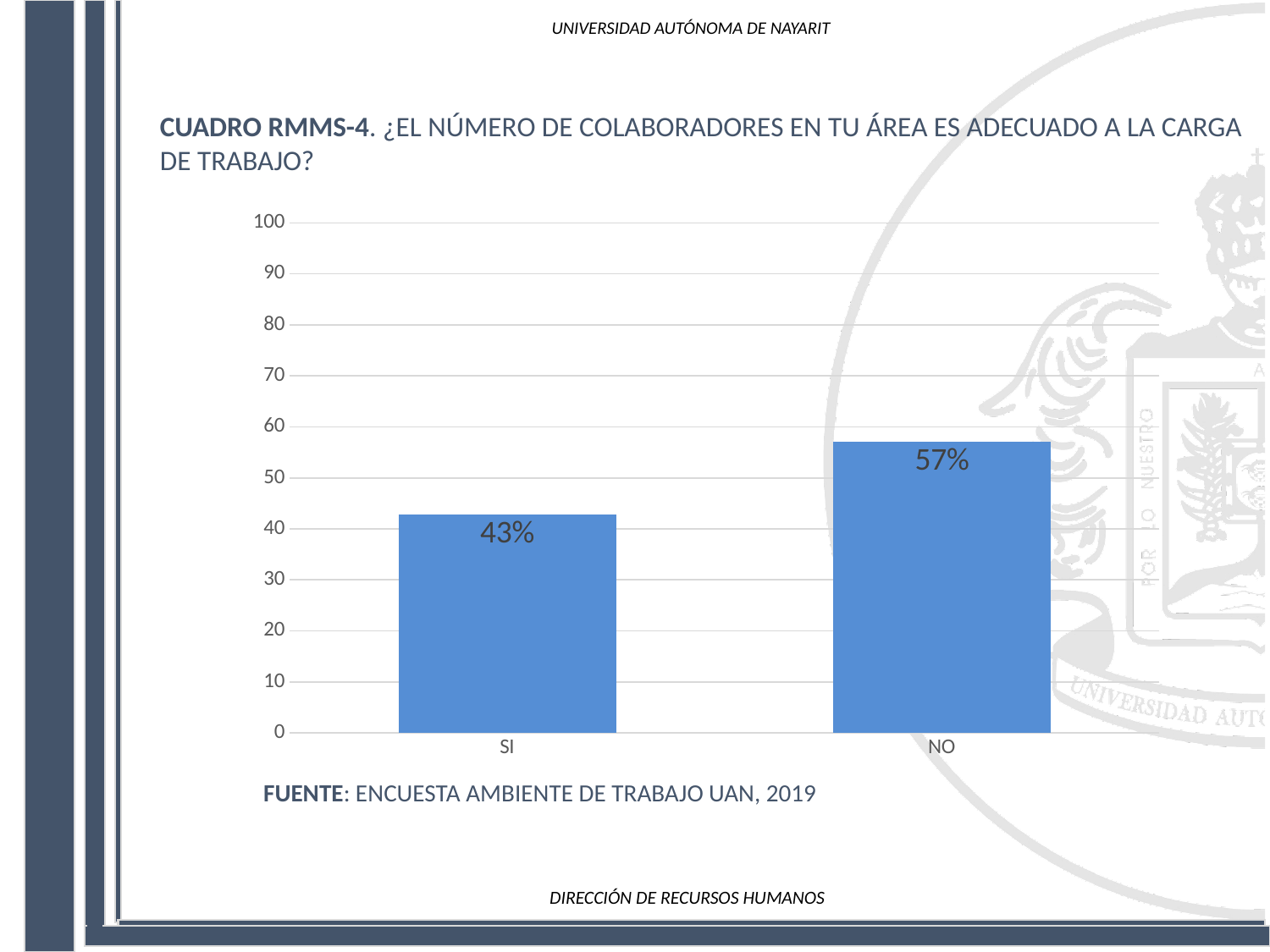
What source is cited below the chart? ENCUESTA AMBIENTE DE TRABAJO UAN, 2019 Which category has the lowest value? SI Which is larger, the value for SI or the value for NO? NO What is the maximum value shown on the y axis? 100 Is the value for SI greater or less than 50? less Which category has the highest value? NO What is the value for SI? 43% What is the value for NO? 57% What is the difference between the values for NO and SI? 14% How many categories are shown on the x axis? 2 Is the value for NO greater or less than 50? greater What kind of chart is shown on the slide? bar chart